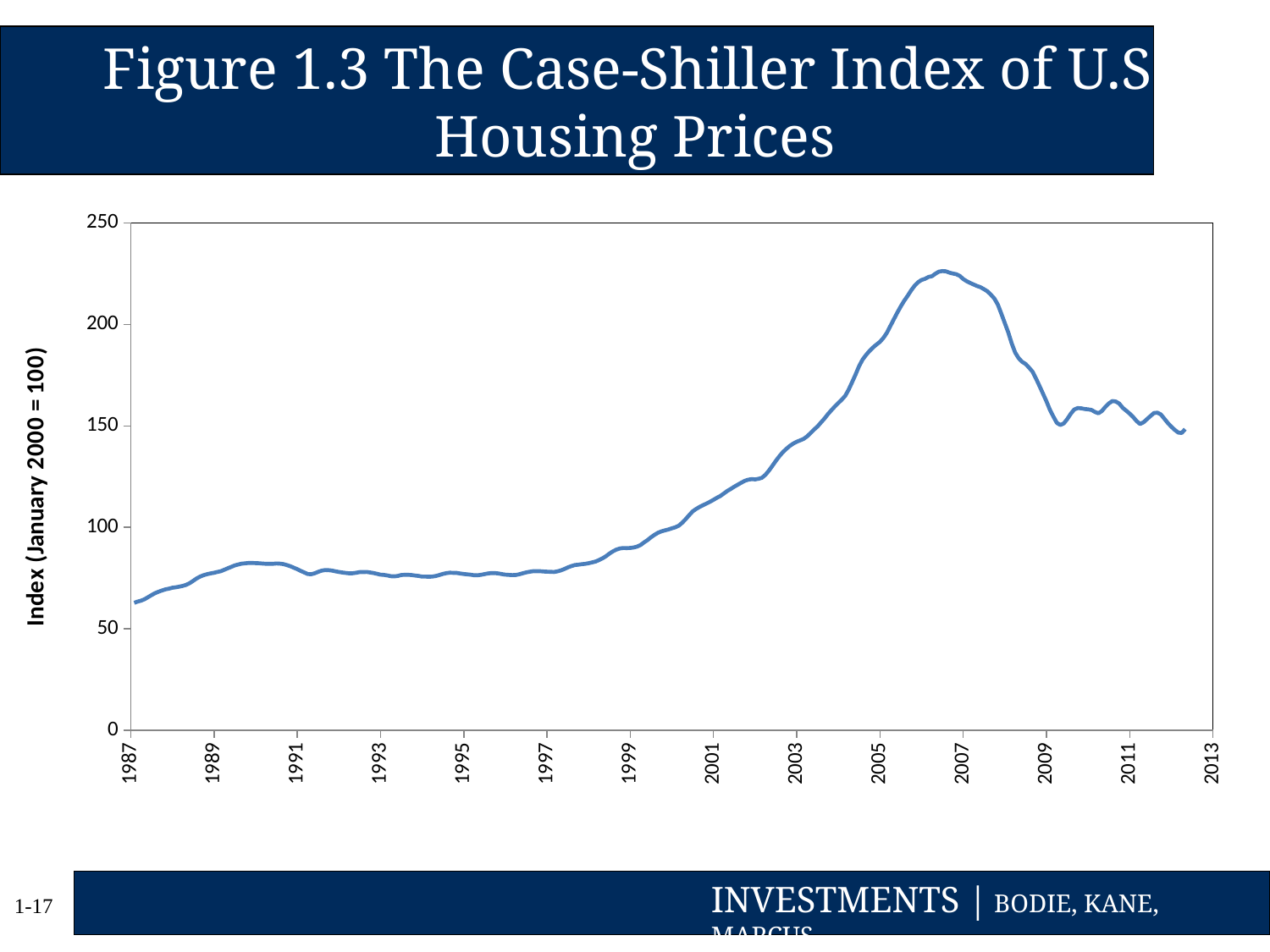
Does the index rise or fall between 2007 and 2009? fall Does the index rise or fall between 2001 and 2005? rise What kind of chart is shown on the slide? line chart Is the value of the index in 2001 greater or less than 150? less How many data series are plotted on the chart? 1 Is the value of the index in 2007 greater or less than 200? greater Is the value of the index in 1995 greater or less than 100? less Which is larger, the index value in 2005 or the index value in 1999? 2005 What is the title of the chart on the slide? Figure 1.3 The Case-Shiller Index of U.S Housing Prices What is the label on the vertical axis of the chart? Index (January 2000 = 100)